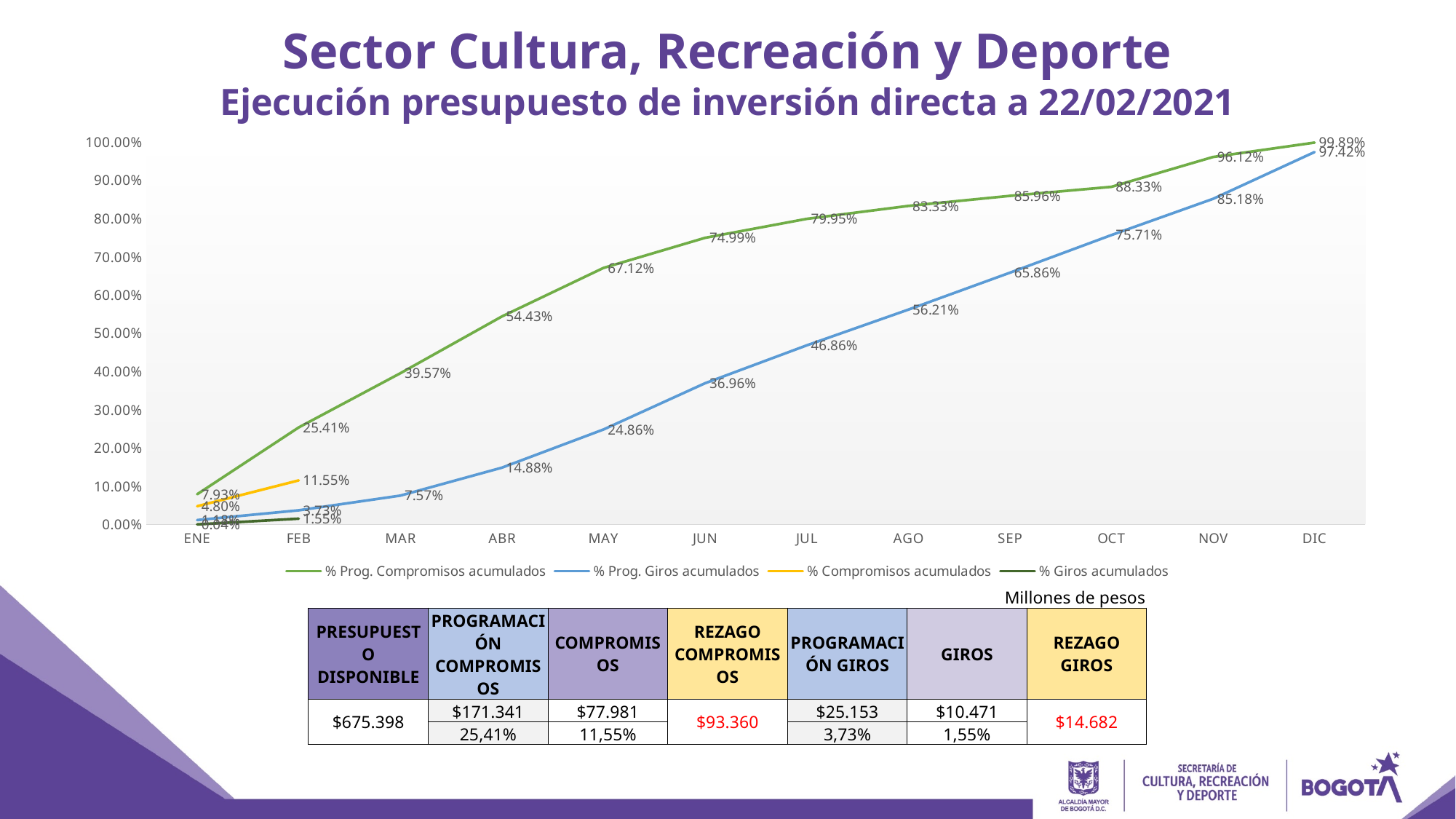
How many series does the chart legend list? 4 What is the value of % Prog. Giros acumulados in JUN? 36.96% What is the value of % Giros acumulados in FEB? 1.55% What is the value of % Prog. Compromisos acumulados in DIC? 99.89% What is the difference between % Prog. Compromisos acumulados and % Prog. Giros acumulados in DIC? 2.47% What is the value of % Compromisos acumulados in FEB? 11.55% How many months are shown along the x axis of the chart? 12 In MAY, which is larger: % Prog. Compromisos acumulados or % Prog. Giros acumulados? % Prog. Compromisos acumulados What colour is the line for % Prog. Giros acumulados? blue Does the % Prog. Giros acumulados line rise or fall from ENE to DIC? rise What kind of chart is shown on the slide? line chart In which month does % Prog. Compromisos acumulados reach its highest value? DIC